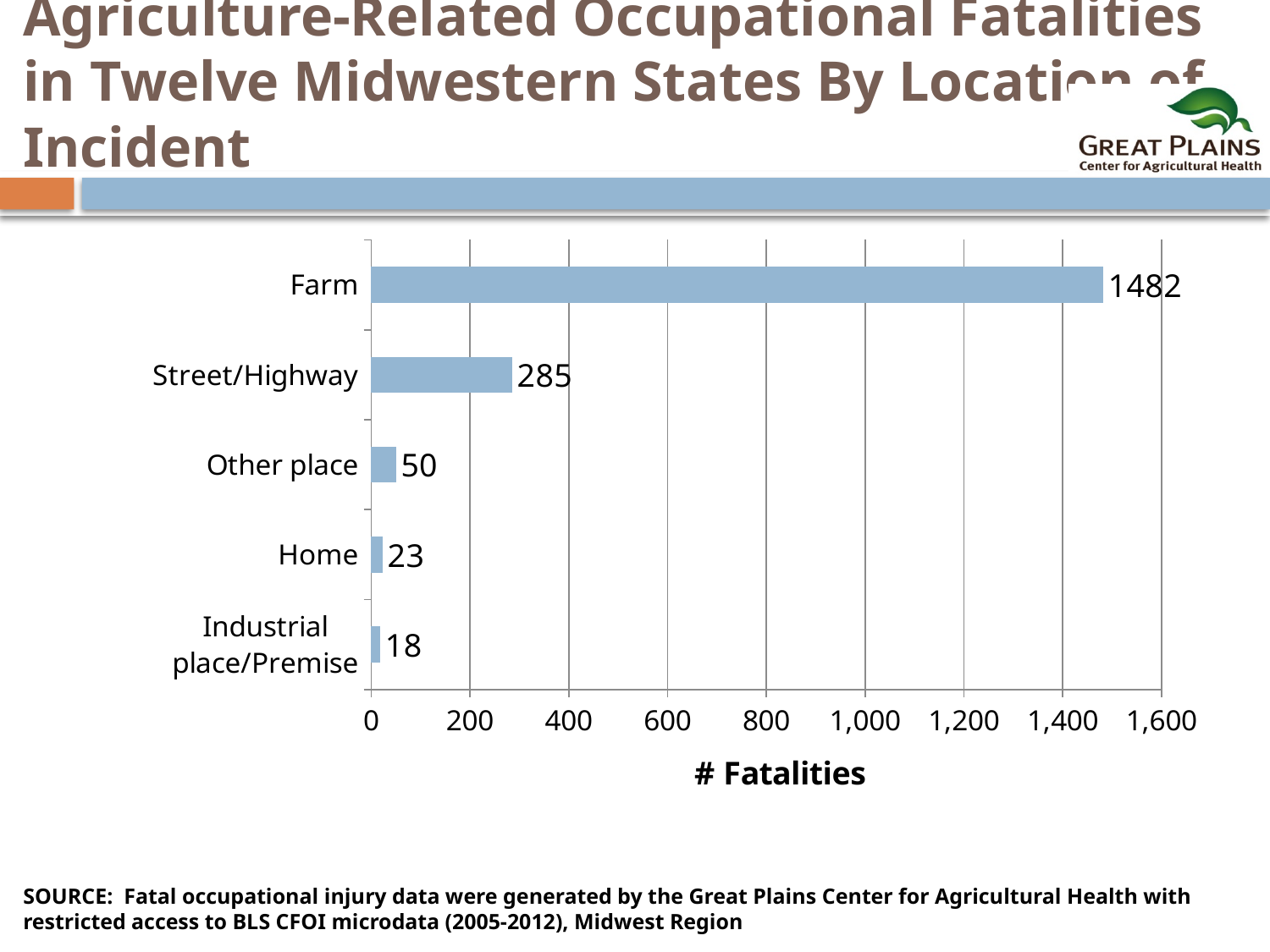
What is the difference in fatalities between Other place and Home? 27 How many location categories are shown in the chart? 5 What is the difference in fatalities between Farm and Street/Highway? 1197 What is the number of fatalities for Street/Highway? 285 Which location has the highest number of fatalities? Farm Which location has the lowest number of fatalities? Industrial place/Premise What is the value for Industrial place/Premise? 18 What type of chart is shown on the slide? Bar chart Which has more fatalities, Street/Highway or Other place? Street/Highway How many fatalities are shown for Home? 23 How many fatalities are shown for Farm? 1482 What is the label of the horizontal axis? # Fatalities